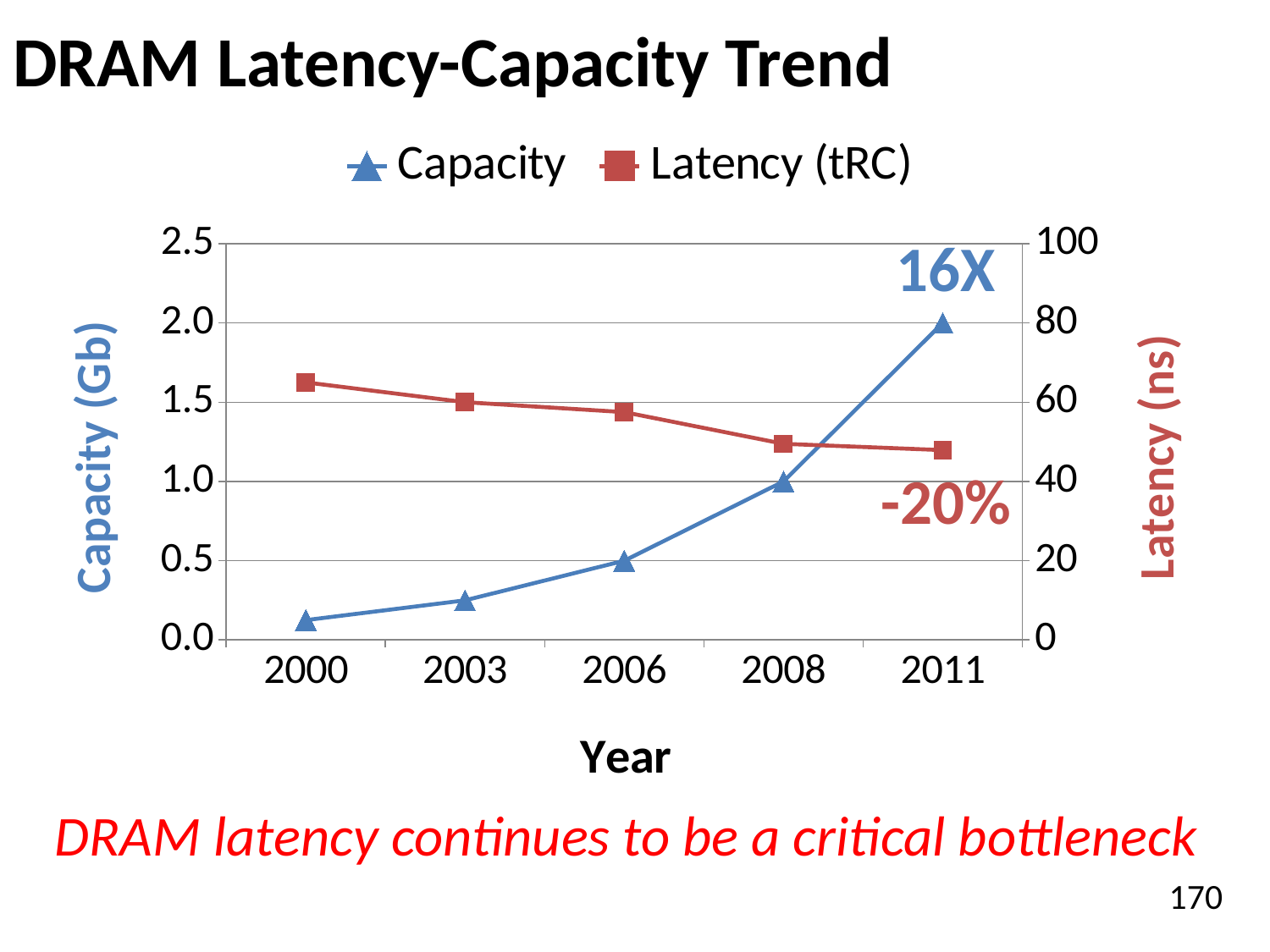
What annotation is printed next to the Capacity line at 2011? 16X What kind of chart is shown on the slide? line chart How many years are plotted along the x axis? 5 Does Capacity rise or fall from 2000 to 2011? rise Which year has the highest Latency (tRC)? 2000 Is the Capacity value for 2003 greater or less than 0.5? less Does Latency (tRC) rise or fall from 2000 to 2011? fall How many series does the legend list? 2 Which year has the lowest Capacity? 2000 Is the Latency (tRC) value for 2000 greater or less than 60? greater Is the Latency (tRC) value for 2011 greater or less than 60? less Which year has the highest Capacity? 2011